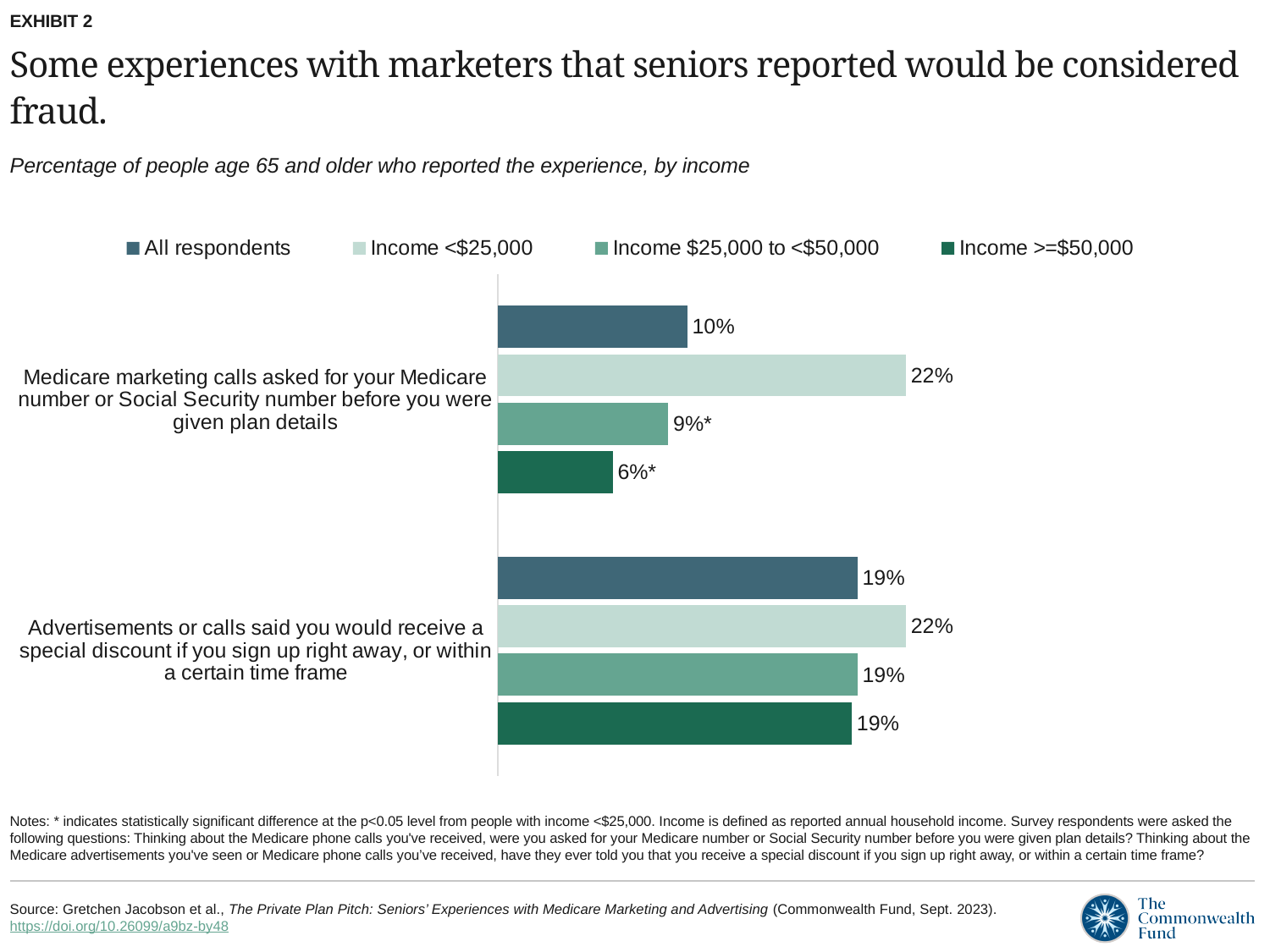
How many categories (experiences) are plotted on the chart? 2 Which legend entry is shown in the darkest green colour? Income >=$50,000 What kind of chart is shown on the slide? bar chart What percentage of all respondents reported that Medicare marketing calls asked for their Medicare number or Social Security number before they were given plan details? 10% For all respondents, which experience has the larger value: being asked for a Medicare or Social Security number before plan details, or being told of a special discount for signing up right away? Advertisements or calls said you would receive a special discount if you sign up right away, or within a certain time frame Which income group has the highest value for the experience of being asked for a Medicare or Social Security number before being given plan details? Income <$25,000 How many series does the legend list? 4 What percentage of respondents with income $25,000 to <$50,000 reported that advertisements or calls said they would receive a special discount if they signed up right away? 19% What percentage of respondents with income <$25,000 reported that Medicare marketing calls asked for their Medicare or Social Security number before plan details were given? 22% What value is shown for Income >=$50,000 for the experience of being asked for a Medicare or Social Security number before being given plan details? 6%* What is the difference between the Income <$25,000 value and the Income >=$50,000 value for the experience of being asked for a Medicare or Social Security number before being given plan details? 16 percentage points Which income group has the lowest value for the experience of being asked for a Medicare or Social Security number before being given plan details? Income >=$50,000